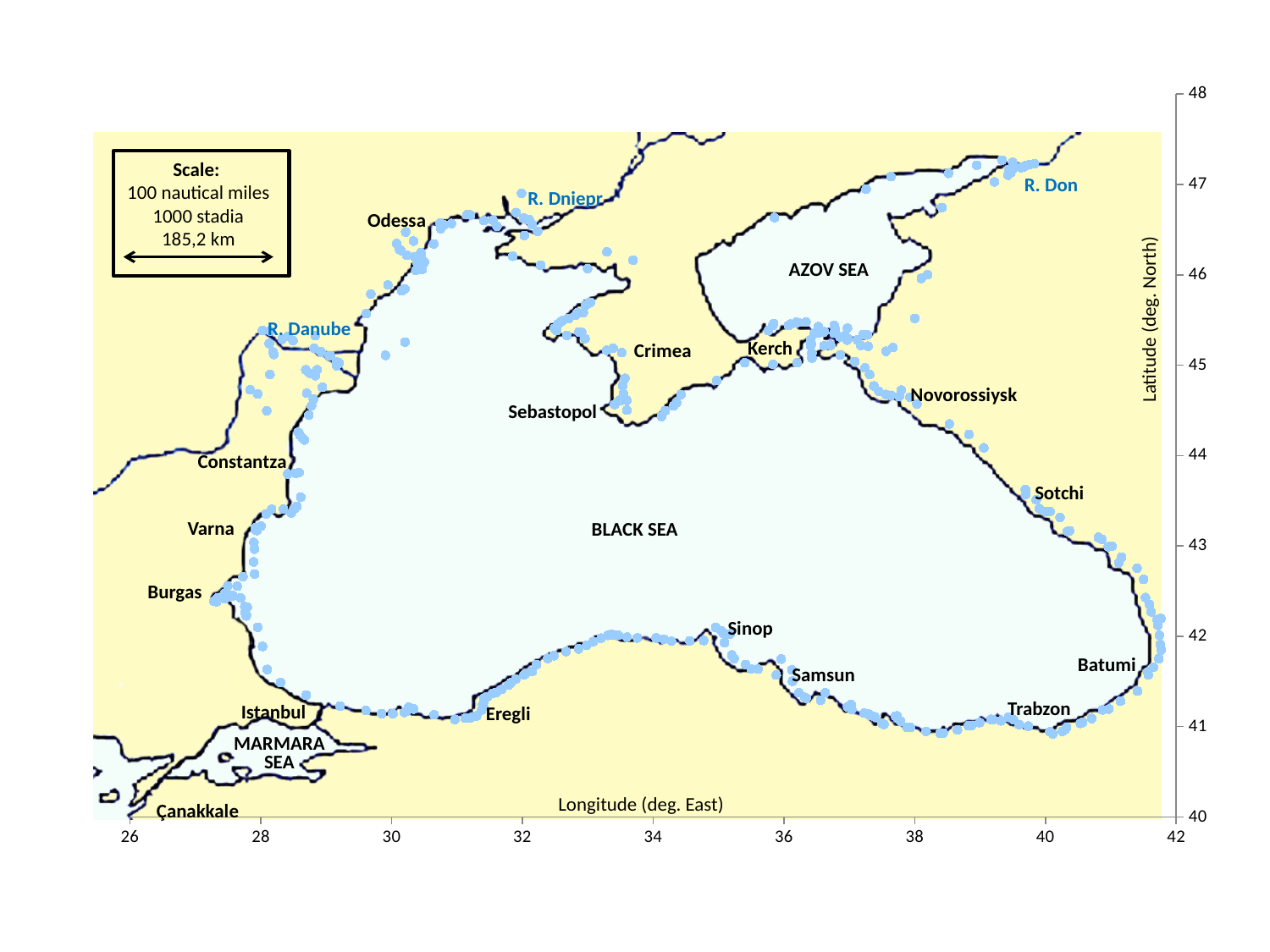
Is the longitude of the points near Odessa greater or less than 30? greater What is the title of the vertical axis? Latitude (deg. North) What is the title of the horizontal axis? Longitude (deg. East) Is the latitude of the points near Odessa greater or less than 46? greater Is the latitude of the points near Sotchi greater or less than 43? greater What kind of chart is overlaid on the map of the Black Sea? scatter chart